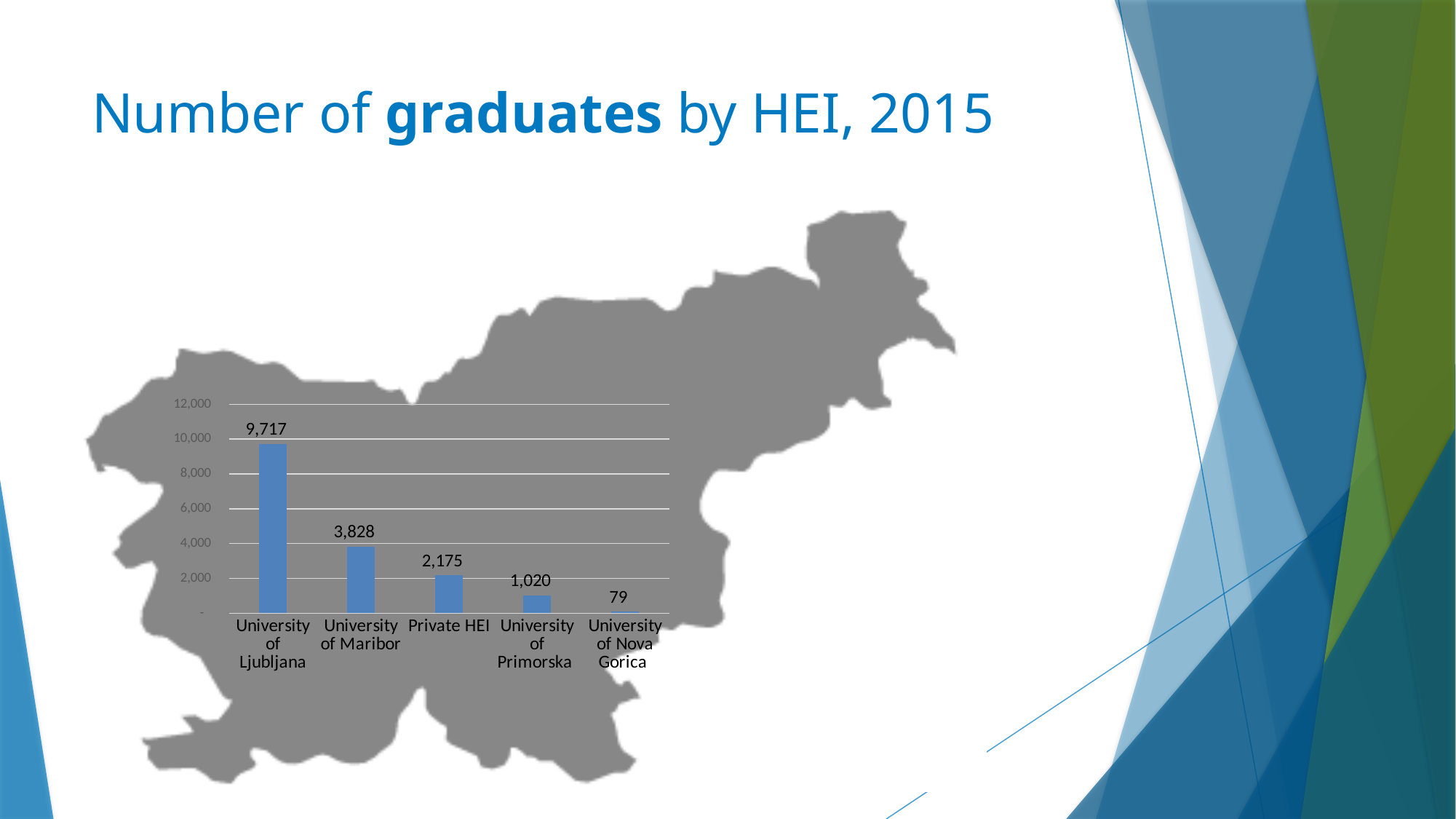
What is the number of graduates for the University of Maribor? 3,828 What type of chart is shown on the slide? Bar chart How many graduates did the University of Ljubljana have in 2015? 9,717 How many HEI categories are shown in the chart? 5 What is the number of graduates for Private HEI? 2,175 Which HEI has the lowest number of graduates? University of Nova Gorica How many graduates did the University of Nova Gorica have? 79 What is the difference in graduates between the University of Ljubljana and the University of Maribor? 5,889 Do the values rise or fall from left to right across the categories? Fall Which HEI has the highest number of graduates? University of Ljubljana What is the difference in graduates between Private HEI and the University of Primorska? 1,155 Which has more graduates, the University of Maribor or Private HEI? University of Maribor